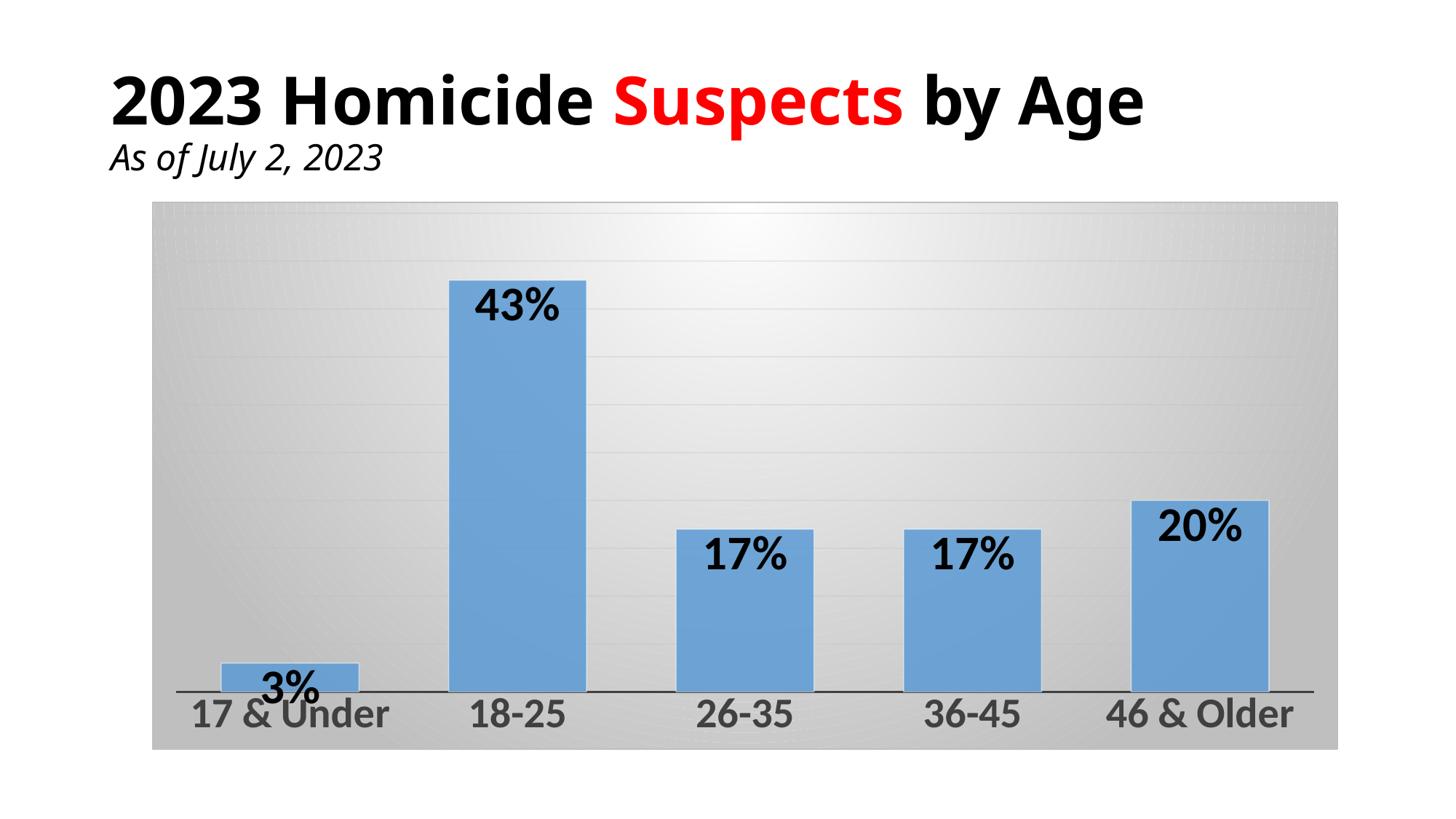
How many age groups are shown on the chart? 5 What kind of chart is shown on the slide? Bar chart Which age group has the lowest share of homicide suspects? 17 & Under What is the value for the 36-45 age group? 17% What is the value shown for the 17 & Under age group? 3% What is the difference between the 46 & Older and 26-35 values? 3% What percentage of 2023 homicide suspects were aged 18-25? 43% Which is larger, the value for 46 & Older or the value for 36-45? 46 & Older Which age group has the highest share of homicide suspects? 18-25 What percentage is shown for the 46 & Older age group? 20% What is the difference between the 18-25 and 46 & Older values? 23% What is the title of the slide? 2023 Homicide Suspects by Age